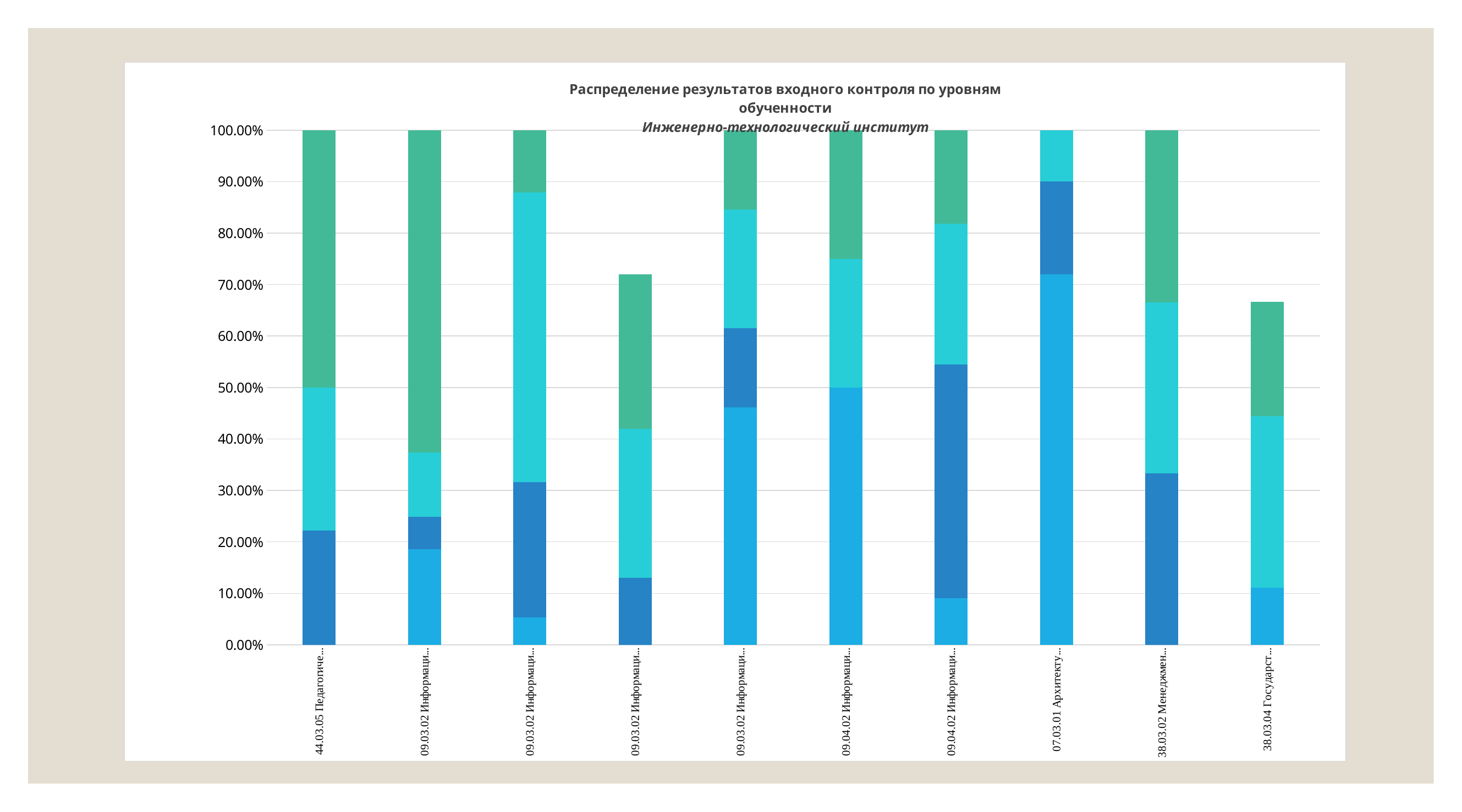
Is the bottom segment of the bar for 07.03.01 Архитекту... greater or less than 60.00%? greater How many bars (categories) are plotted in the chart? 10 What is the main title of the chart? Распределение результатов входного контроля по уровням обученности Which category has the lowest total bar height? 38.03.04 Государст... Is the bottom segment of the bar for 44.03.05 Педагогиче... greater or less than 30.00%? less Is the bottom segment of the bar for 38.03.02 Менеджмен... greater or less than 40.00%? less What kind of chart is shown on the slide? bar chart Which institute is named in the italic subtitle of the chart? Инженерно-технологический институт Which bar has the larger total height: 44.03.05 Педагогиче... or 38.03.04 Государст...? 44.03.05 Педагогиче...